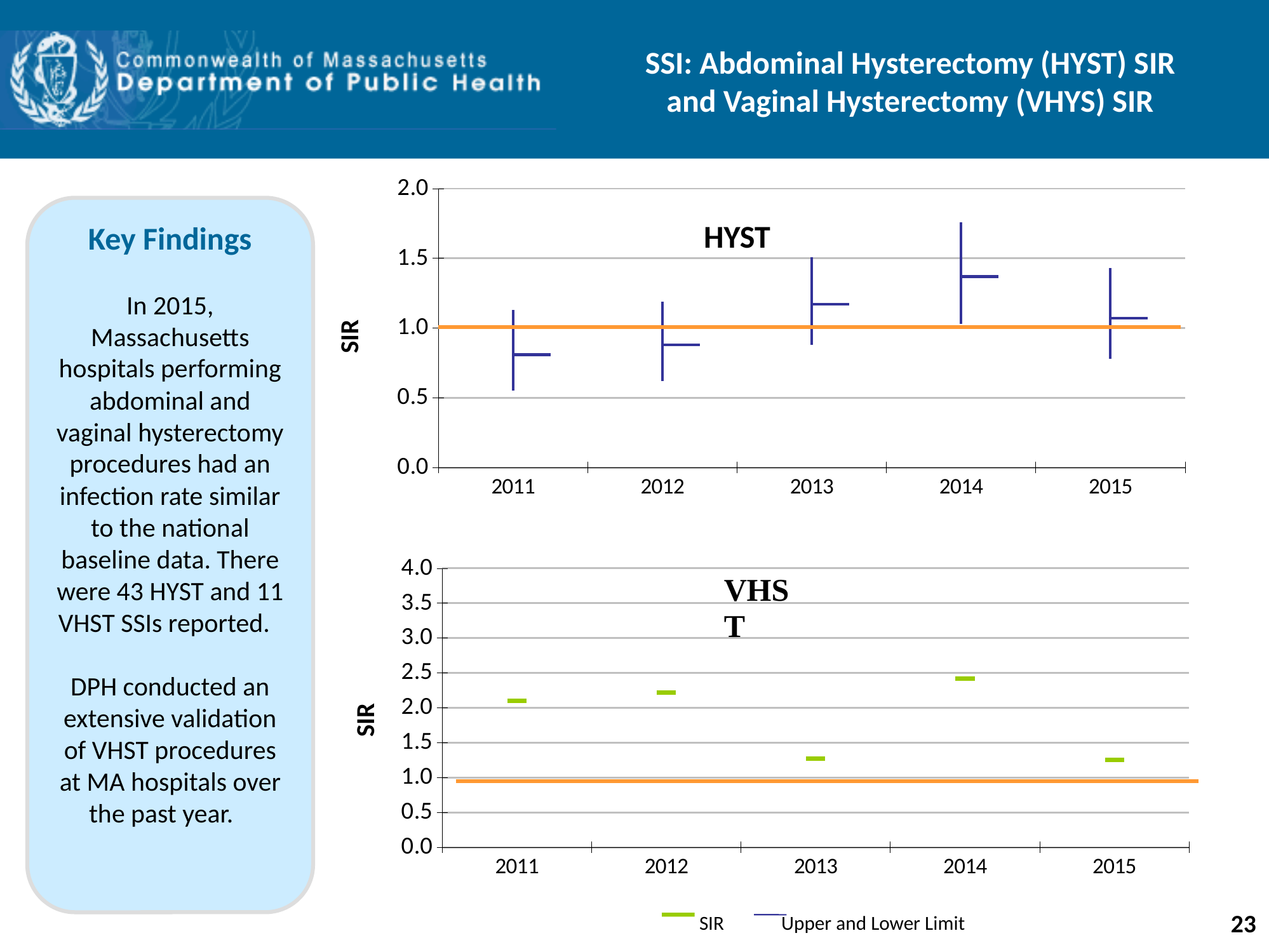
In the VHST chart, which year has the highest SIR value? 2014 In the HYST chart, which year has the highest SIR value? 2014 What is the label on the y axis of the VHST chart? SIR In the VHST chart, is the SIR value for 2013 greater or less than 1.5? less What is the highest value shown on the y axis of the VHST chart? 4.0 In the HYST chart, is the SIR value for 2011 greater or less than 1.0? less In the HYST chart, which year has the larger SIR value, 2011 or 2014? 2014 In the VHST chart, which year has the larger SIR value, 2013 or 2014? 2014 In the HYST chart, is the SIR value for 2014 greater or less than 1.0? greater How many years are shown on the x axis of the HYST chart? 5 How many entries does the legend at the bottom of the slide list? 2